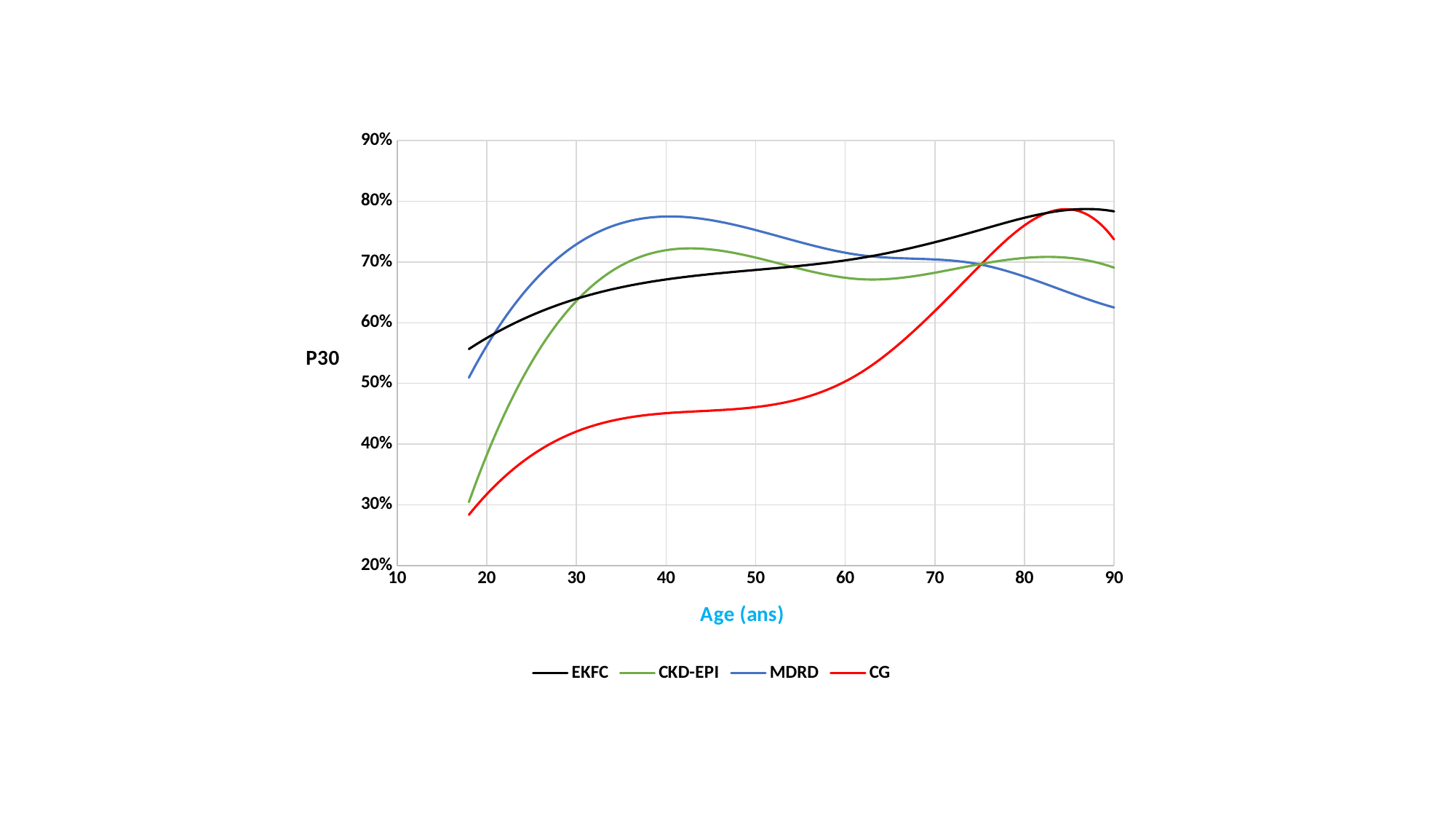
Does the CG line rise or fall between age 50 and age 80? rise Is the value for EKFC at age 90 greater or less than 70%? greater What kind of chart is shown on the slide? line chart Which series has the lowest value at age 40? CG Is the value for CKD-EPI at age 60 greater or less than 70%? less What is the label of the y axis? P30 What is the label of the x axis? Age (ans) How many series does the legend list? 4 At age 90, which is larger, EKFC or MDRD? EKFC Which series has the highest value at age 40? MDRD Is the value for MDRD at age 40 greater or less than 70%? greater